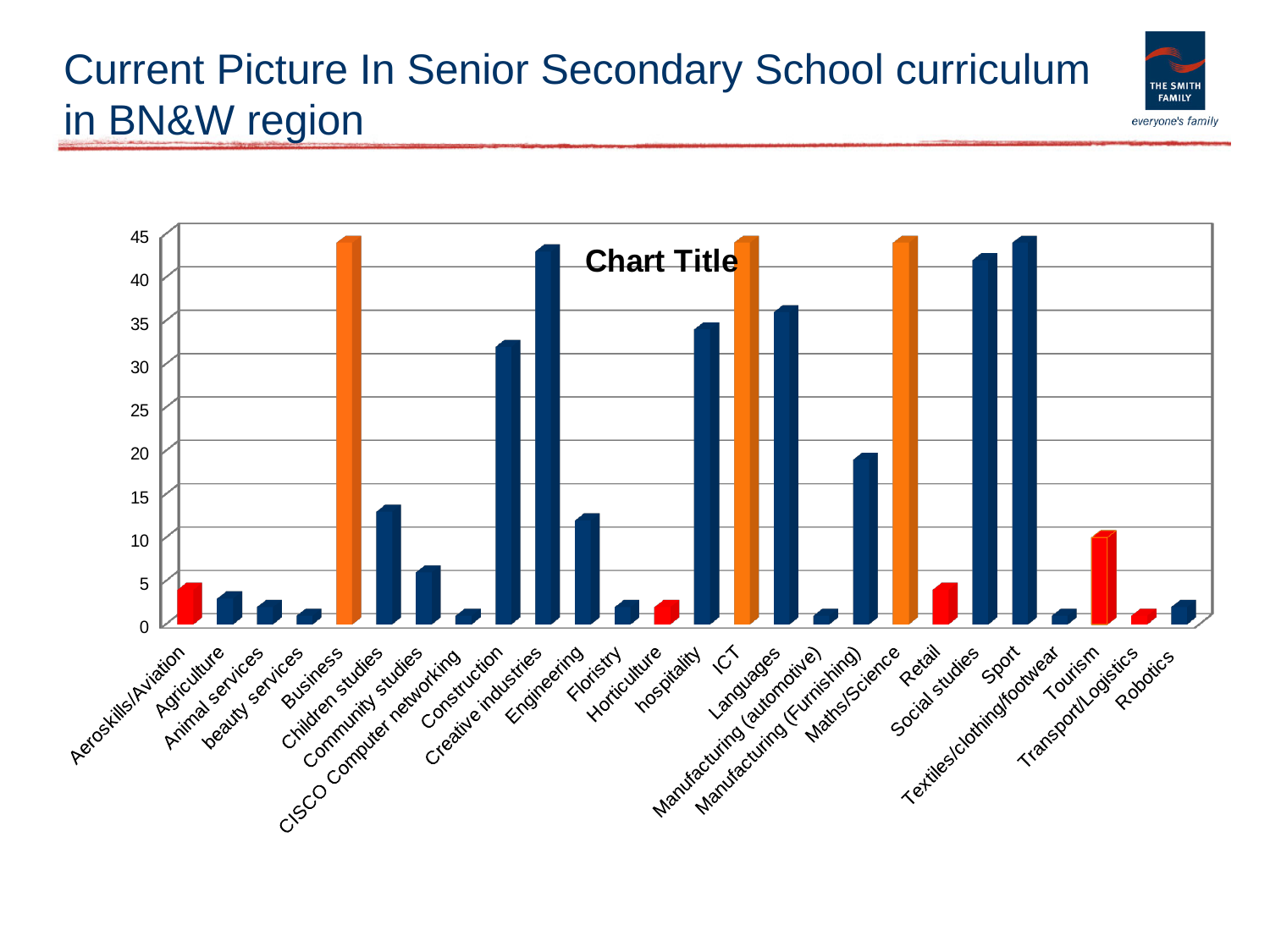
Is the value for Construction greater or less than 25? greater What is the title printed on the chart? Chart Title Is the value for Tourism greater or less than 5? greater Which three categories have orange bars? Business, ICT, Maths/Science Is the value for Languages greater or less than 30? greater What kind of chart is shown on the slide? bar chart Which is larger, the value for Construction or the value for Creative industries? Creative industries How many categories are shown along the x axis of the chart? 26 Which is larger, the value for Children studies or the value for Community studies? Children studies